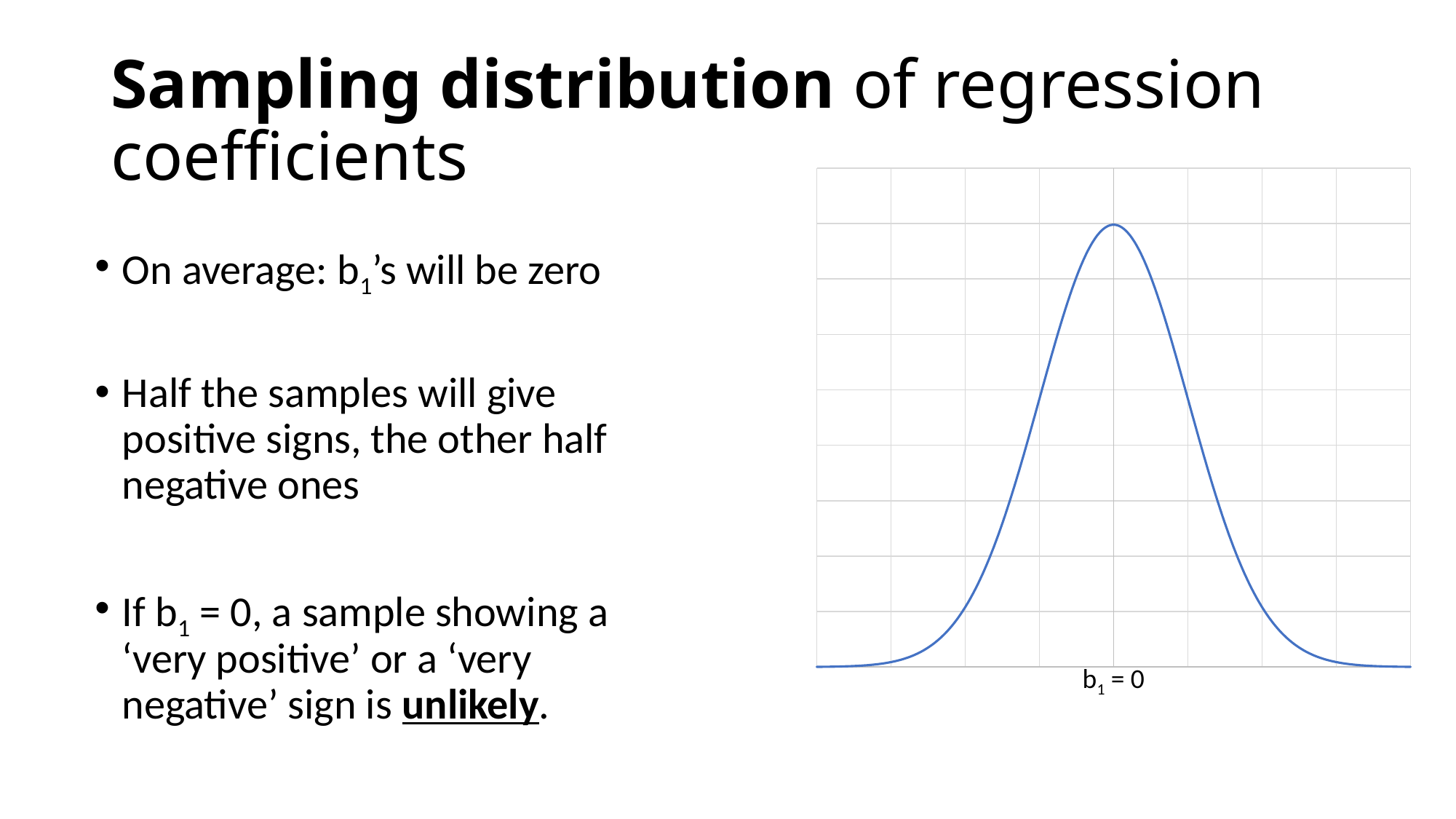
Moving from the centre of the chart toward the right edge, does the curve rise or fall? fall How many lines are plotted on the chart? 1 Moving from the left edge of the chart toward the centre, does the curve rise or fall? rise What label is printed below the x axis of the chart? b1 = 0 Is the curve's value at the far right edge of the chart higher or lower than its value at the centre? lower At which labelled point on the x axis does the curve reach its highest value? b1 = 0 Is the curve's value at the far left edge of the chart higher or lower than its value at the centre? lower What kind of chart is shown on the slide? line chart What colour is the curve plotted on the chart? blue